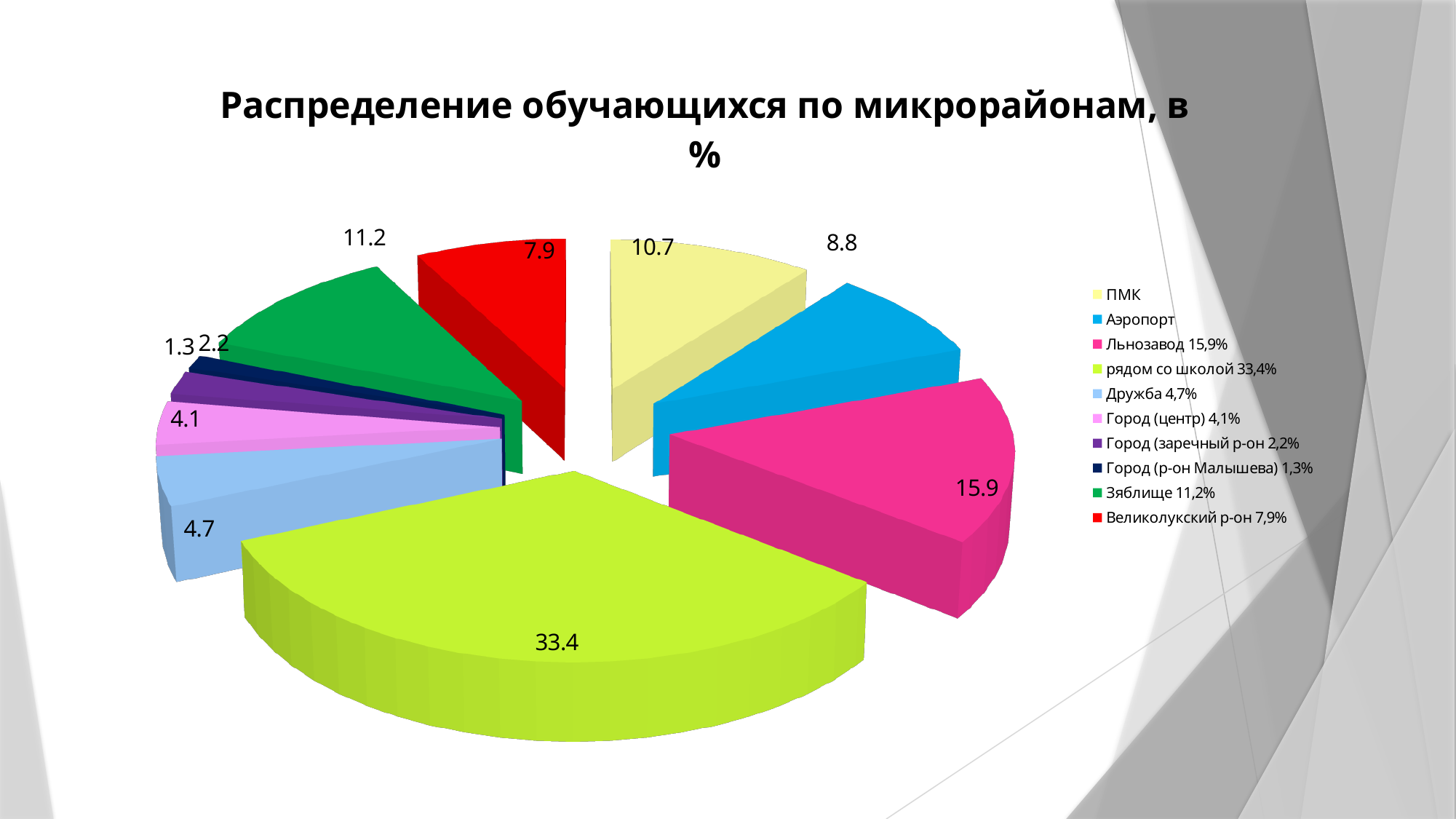
What is the value shown for the slice 'Зяблище'? 11.2 Which category has the largest slice of the pie? рядом со школой What is the difference between the values for 'рядом со школой' and 'Льнозавод'? 17.5 What is the value shown for the slice 'ПМК'? 10.7 How many slices does the pie chart have? 10 What kind of chart is shown on the slide? pie chart What is the value shown for the slice 'Аэропорт'? 8.8 Which category has the smallest slice of the pie? Город (р-он Малышева) Which is larger, the value for 'Дружба' or the value for 'Город (центр)'? Дружба What is the value shown for the slice 'Льнозавод'? 15.9 What is the value shown for the slice 'рядом со школой'? 33.4 What is the title of the chart? Распределение обучающихся по микрорайонам, в %